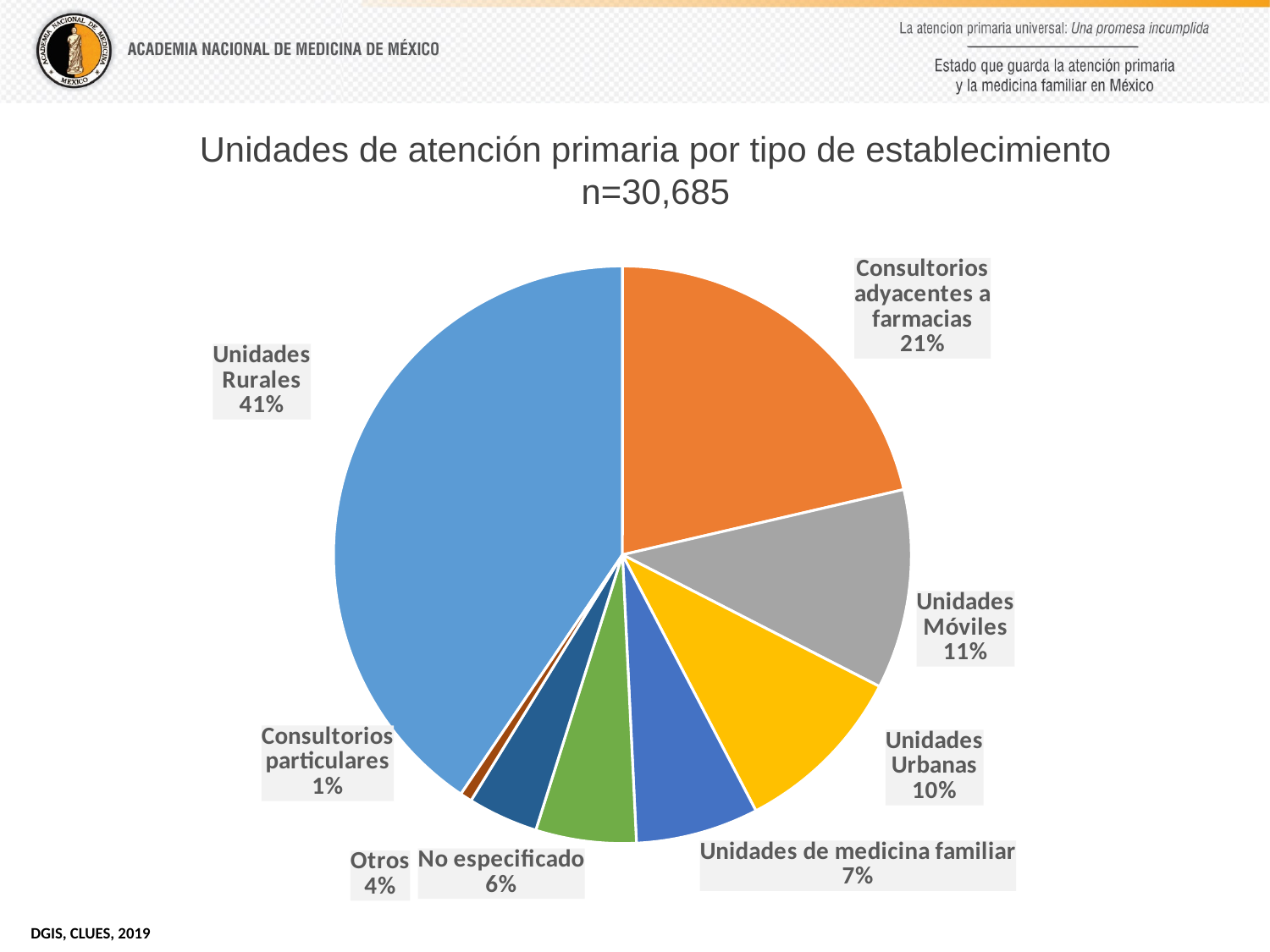
What percentage is shown for Unidades Móviles? 11% What is the title of the chart? Unidades de atención primaria por tipo de establecimiento n=30,685 What share of primary care units are Unidades Rurales? 41% What is the difference in percentage points between Unidades Rurales and Consultorios adyacentes a farmacias? 20 How many categories are shown in the pie chart? 8 Which is larger, the share for Unidades Urbanas or the share for No especificado? Unidades Urbanas Which category has the smallest slice of the pie? Consultorios particulares What percentage is shown for Unidades de medicina familiar? 7% What type of chart is shown on the slide? pie chart What is the total number of units (n) stated in the chart title? 30,685 Which category has the largest slice of the pie? Unidades Rurales What percentage is shown for Consultorios adyacentes a farmacias? 21%